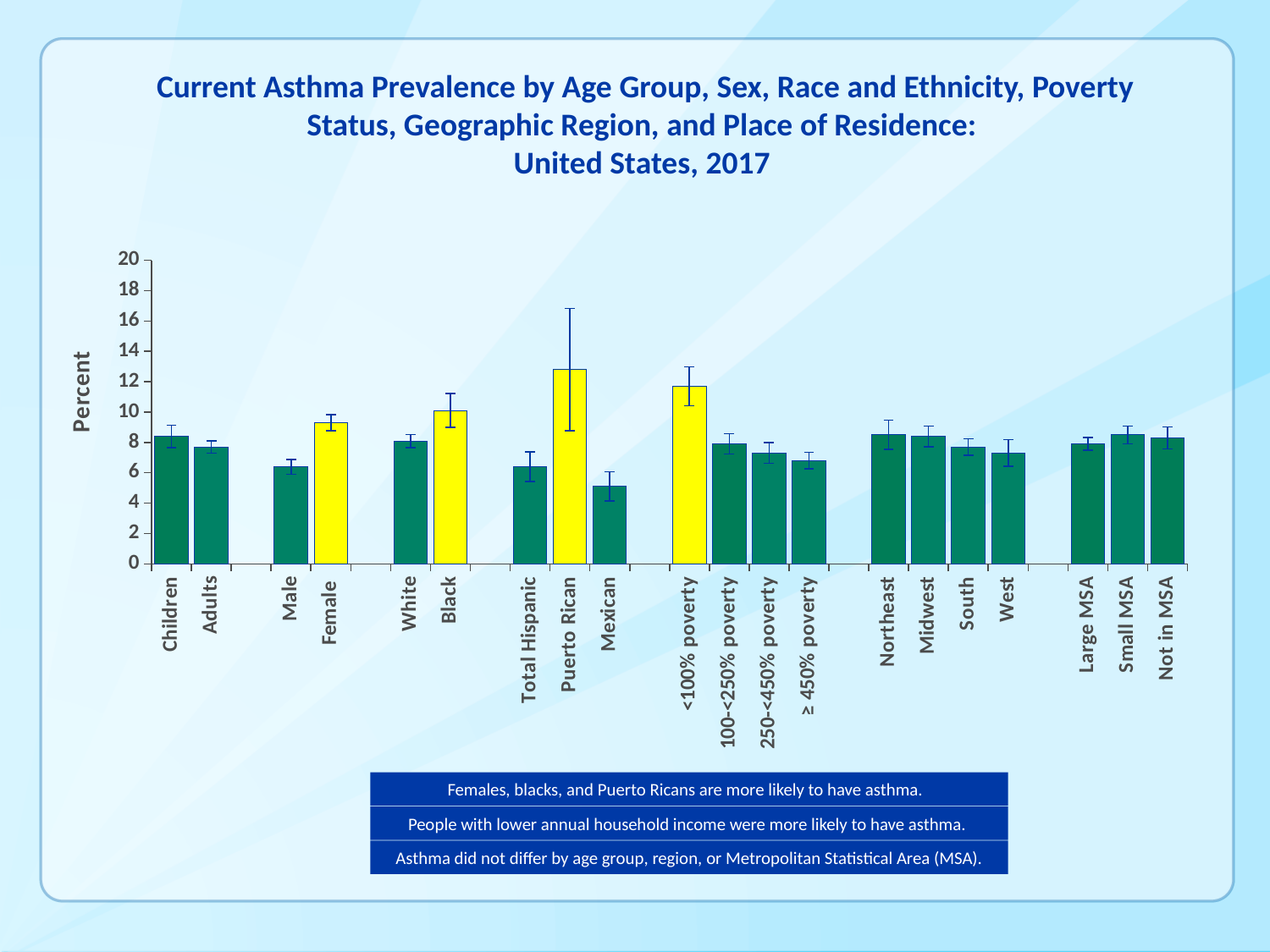
Which category has the lowest asthma prevalence? Mexican Is the value for Puerto Rican greater or less than 12? greater Is the value for <100% poverty greater or less than 10? greater Across the four poverty status categories from <100% poverty to ≥ 450% poverty, do the values rise or fall? fall Which category has the highest asthma prevalence? Puerto Rican Which is larger, the value for Female or the value for Male? Female What is the label on the y axis? Percent What kind of chart is shown on the slide? bar chart Is the value for Mexican greater or less than 6? less How many categories are plotted on the x axis? 20 Which is larger, the value for Black or the value for White? Black